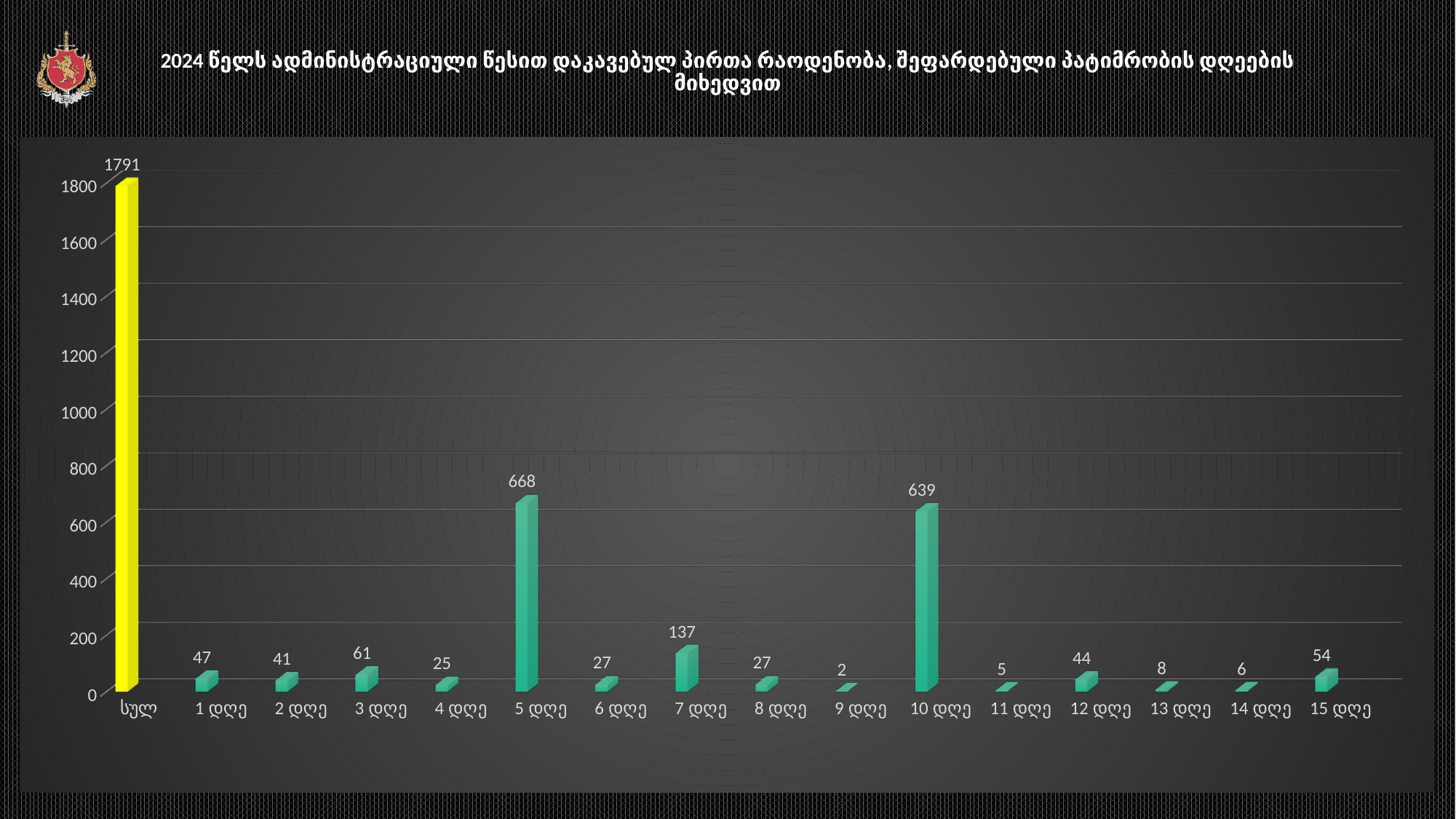
What is the value for "სულ"? 1791 What is the value for "7 დღე"? 137 Which is larger, the value for "3 დღე" or the value for "15 დღე"? 3 დღე What is the difference between the values for "5 დღე" and "10 დღე"? 29 What kind of chart is shown on the slide? bar chart Which category has the lowest value? 9 დღე Is the value for "7 დღე" greater or less than 200? less Excluding "სულ", which category has the highest value? 5 დღე What colour is the bar for "სულ"? yellow What is the value for "5 დღე"? 668 What is the value for "10 დღე"? 639 How many categories are shown on the x axis? 16